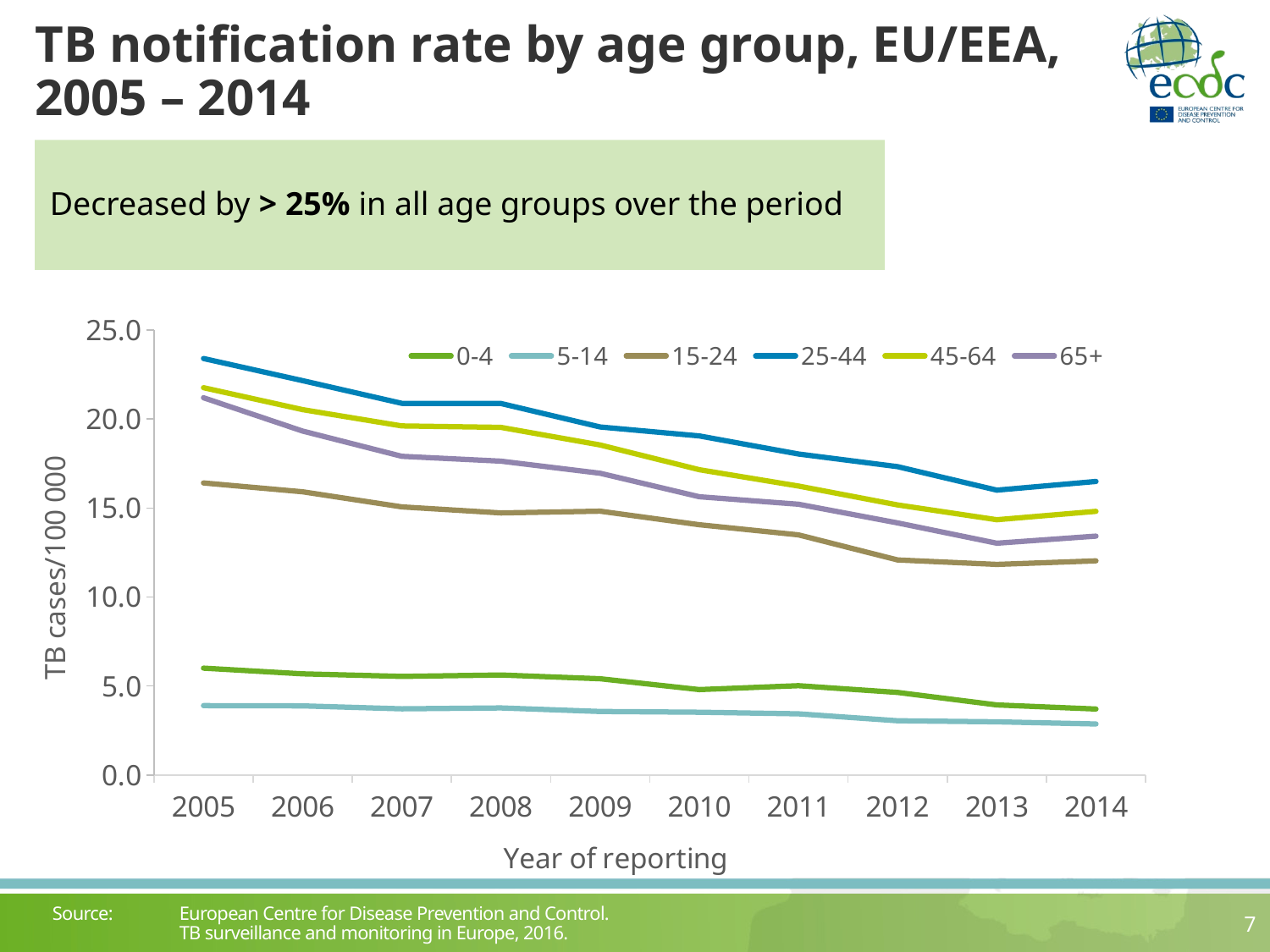
Which is larger in 2010, the value for the 25-44 age group or the 15-24 age group? 25-44 Is the value for the 25-44 age group in 2005 greater or less than 20.0? greater Is the value for the 15-24 age group in 2014 greater or less than 15.0? less Which age group has the highest TB notification rate in 2005? 25-44 Does the TB notification rate for the 25-44 age group rise or fall from 2005 to 2014? Fall How many years are plotted along the x axis? 10 Which is larger in 2005, the value for the 0-4 age group or the 5-14 age group? 0-4 How many series does the legend list? 6 Is the value for the 0-4 age group in 2005 greater or less than 5.0? greater What is the label of the y axis? TB cases/100 000 Which age group has the lowest TB notification rate in 2014? 5-14 What kind of chart is shown on the slide? Line chart